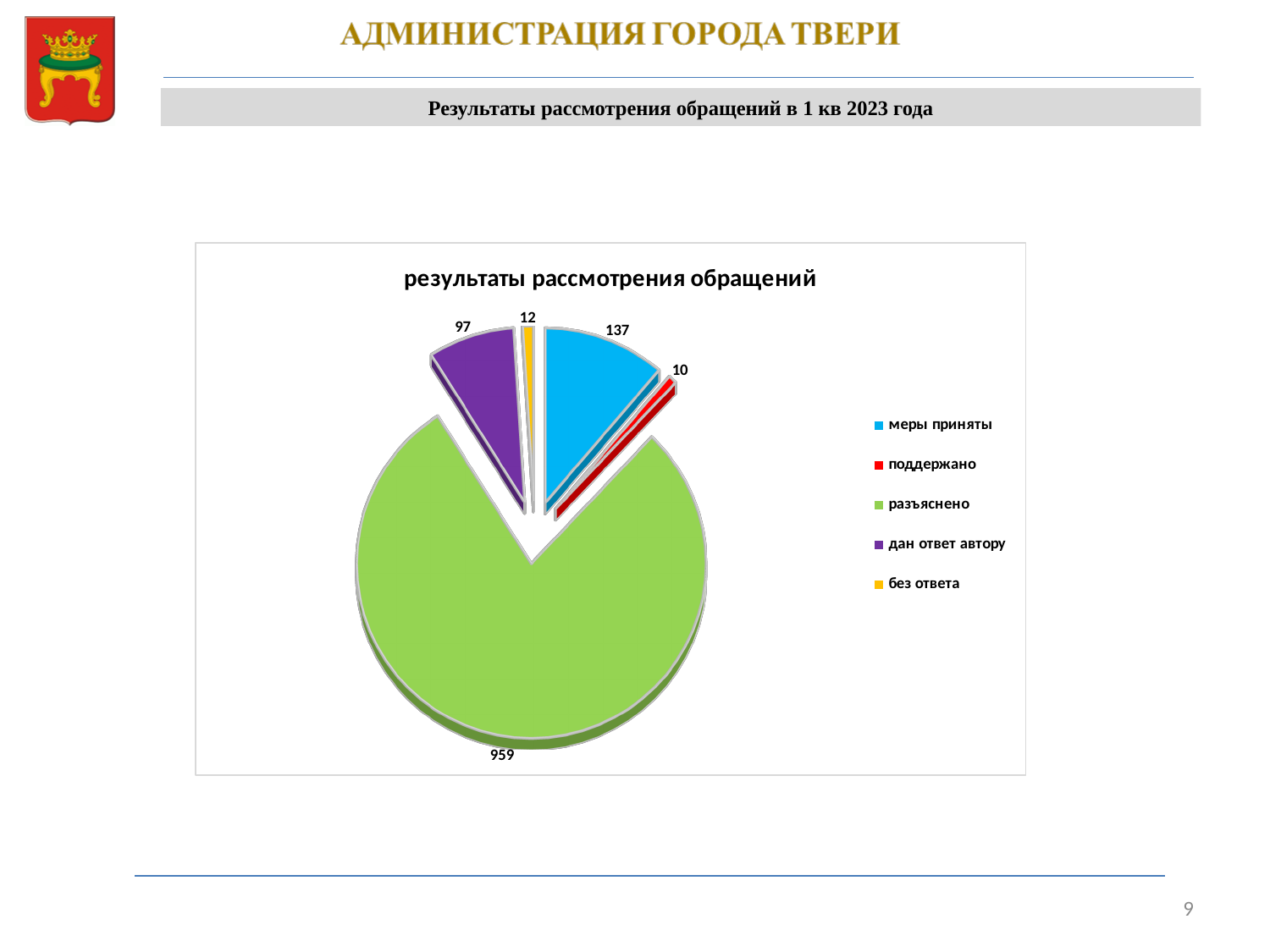
Which is larger, the value for "без ответа" or the value for "поддержано"? без ответа What is the value for "без ответа" in the pie chart? 12 What is the value for "дан ответ автору" in the pie chart? 97 What is the value for "поддержано" in the pie chart? 10 Which category has the smallest slice in the pie chart? поддержано How many categories does the pie chart have? 5 What is the value for "разъяснено" in the pie chart? 959 What is the difference between the values for "меры приняты" and "дан ответ автору"? 40 What type of chart is shown on the slide? pie chart What is the value for "меры приняты" in the pie chart? 137 What is the title of the chart? результаты рассмотрения обращений Which category has the largest slice in the pie chart? разъяснено